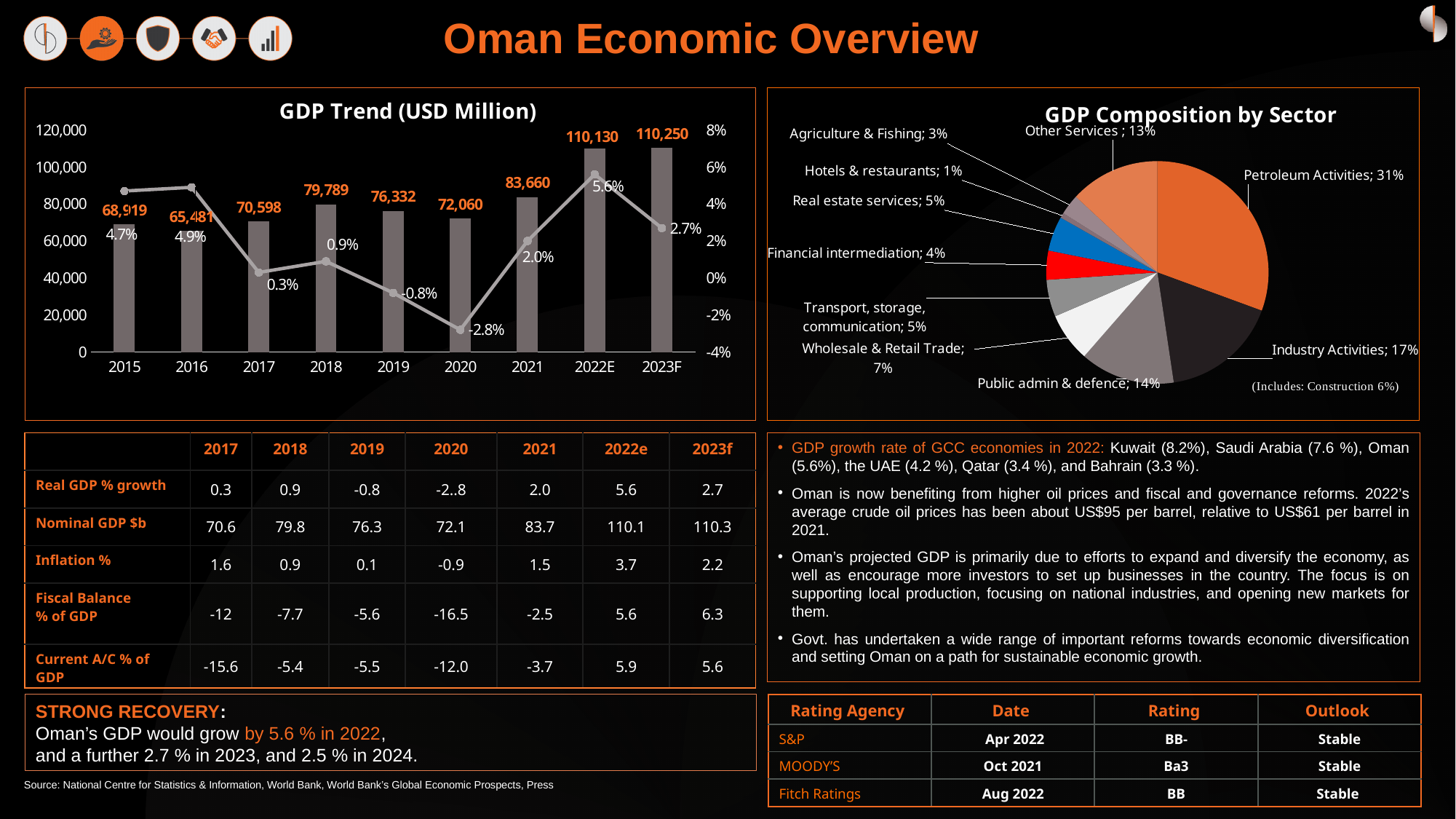
In the GDP Trend (USD Million) chart, what growth rate is shown on the line for 2020? -2.8% In the GDP Trend (USD Million) chart, do the GDP bars rise or fall from 2020 to 2022E? rise How many years are shown on the x axis of the GDP Trend (USD Million) chart? 9 In the GDP Composition by Sector chart, what is the difference in percentage points between Industry Activities and Public admin & defence? 3 In the GDP Trend (USD Million) chart, what is the GDP value for 2021? 83,660 In the GDP Composition by Sector chart, which sector has the smallest slice? Hotels & restaurants How many sectors are shown in the GDP Composition by Sector pie chart? 10 In the GDP Composition by Sector chart, what share does Petroleum Activities have? 31% In the GDP Trend (USD Million) chart, which year has the lowest growth rate on the line? 2020 In the GDP Trend (USD Million) chart, which year has the larger GDP bar, 2018 or 2019? 2018 In the GDP Trend (USD Million) chart, which year has the highest GDP bar? 2023F In the GDP Trend (USD Million) chart, what is the difference between the GDP values for 2023F and 2022E? 120